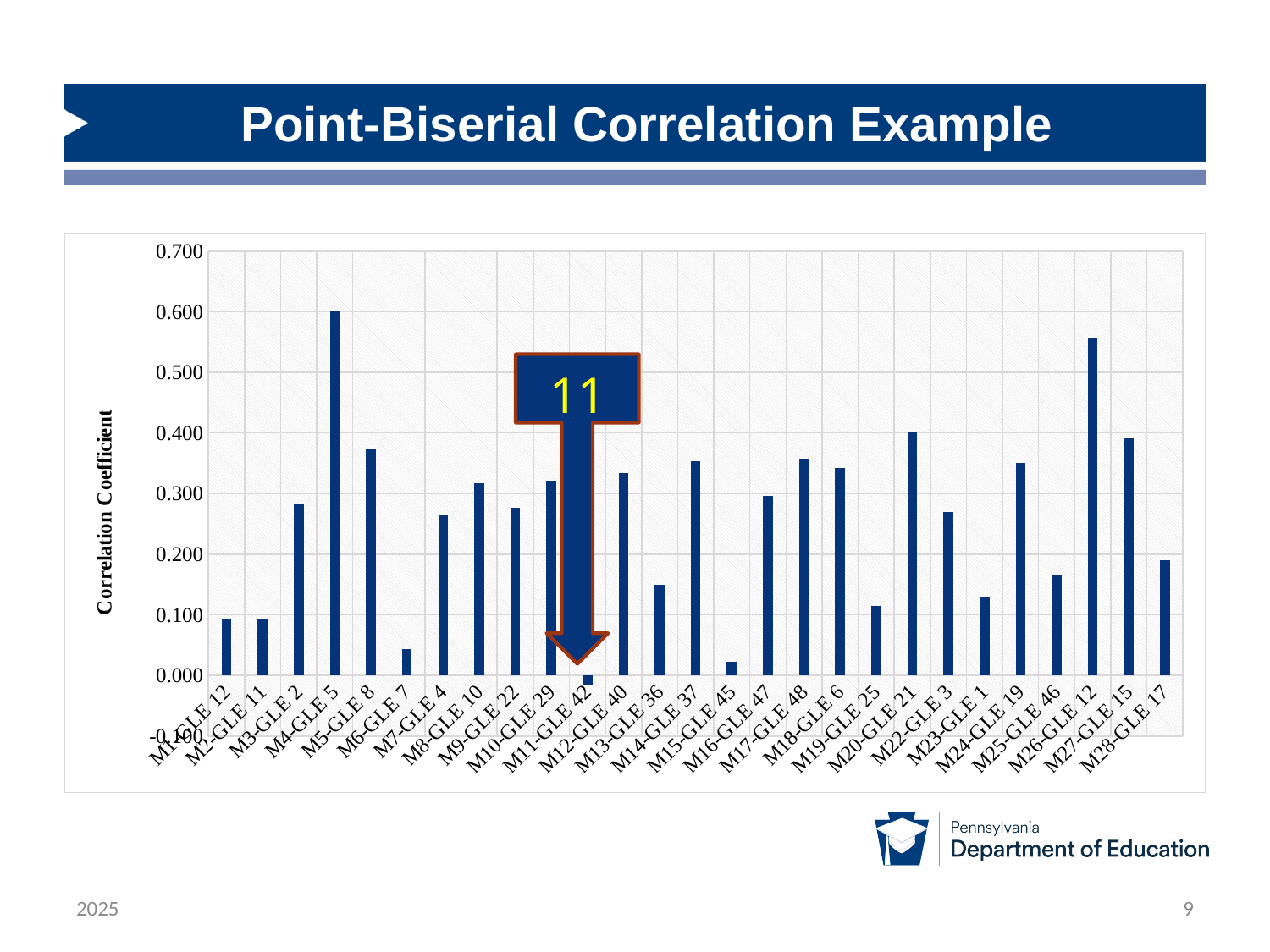
Is the value for M5-GLE 8 greater or less than 0.300? greater What kind of chart is shown on the slide? bar chart Is the value for M26-GLE 12 greater or less than 0.500? greater Is the value for M6-GLE 7 greater or less than 0.100? less How many categories (bars) are plotted on the chart? 27 Which has the larger correlation coefficient, M4-GLE 5 or M26-GLE 12? M4-GLE 5 Which has the larger correlation coefficient, M17-GLE 48 or M13-GLE 36? M17-GLE 48 Which category has the lowest correlation coefficient? M11-GLE 42 What is the label on the vertical axis of the chart? Correlation Coefficient Which category has the highest correlation coefficient? M4-GLE 5